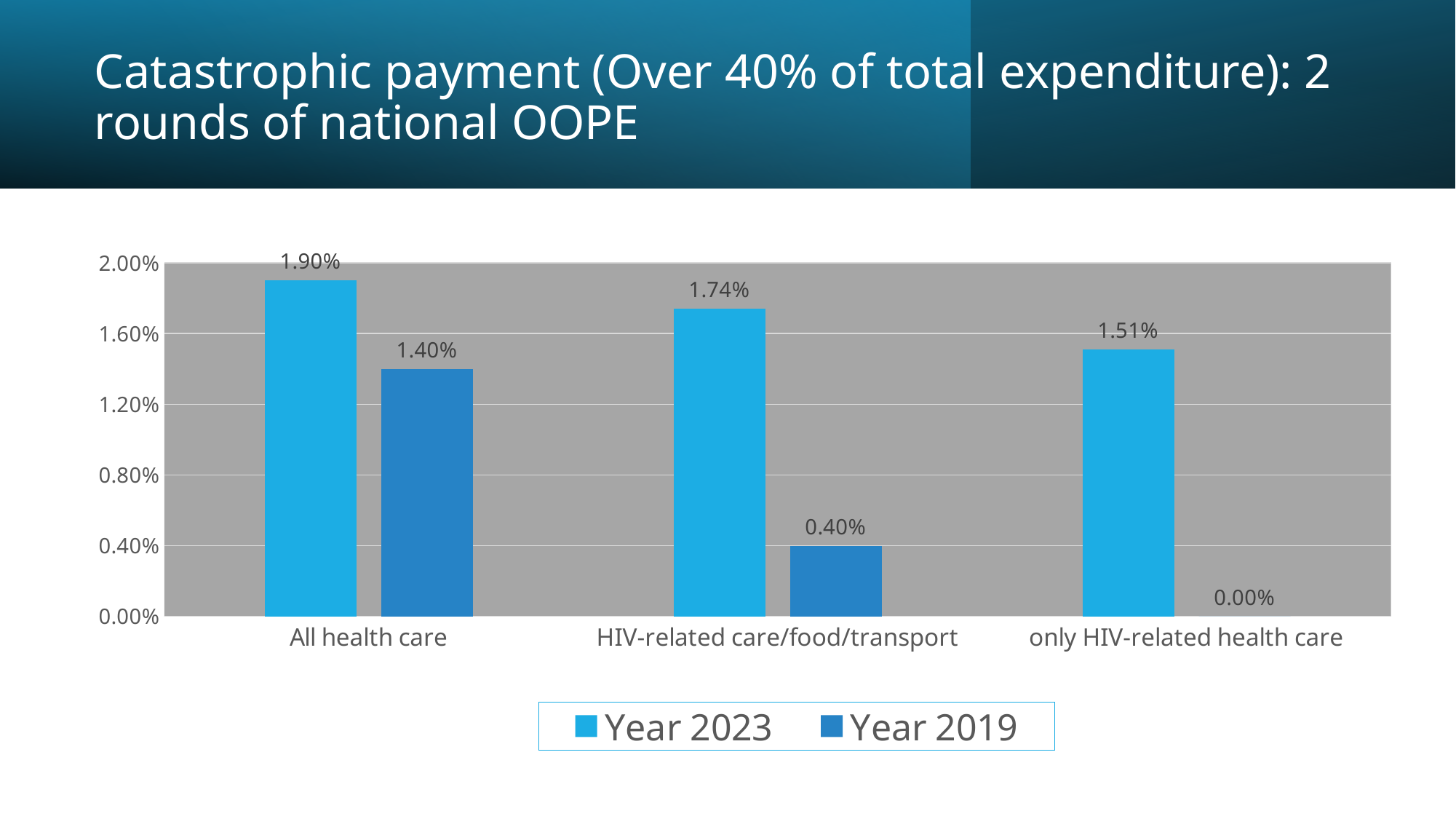
Which category has the highest Year 2023 value? All health care How many series does the legend list? 2 What is the Year 2019 value for HIV-related care/food/transport? 0.40% What is the Year 2023 value for only HIV-related health care? 1.51% What is the Year 2023 value for All health care? 1.90% Which category has the lowest Year 2019 value? only HIV-related health care How many categories are shown on the x axis? 3 Which is larger: the Year 2019 value for All health care or the Year 2019 value for HIV-related care/food/transport? All health care What is the difference between the Year 2023 and Year 2019 values for HIV-related care/food/transport? 1.34% What is the Year 2019 value for only HIV-related health care? 0.00% What is the difference between the Year 2023 and Year 2019 values for All health care? 0.50% What kind of chart is shown on the slide? Bar chart